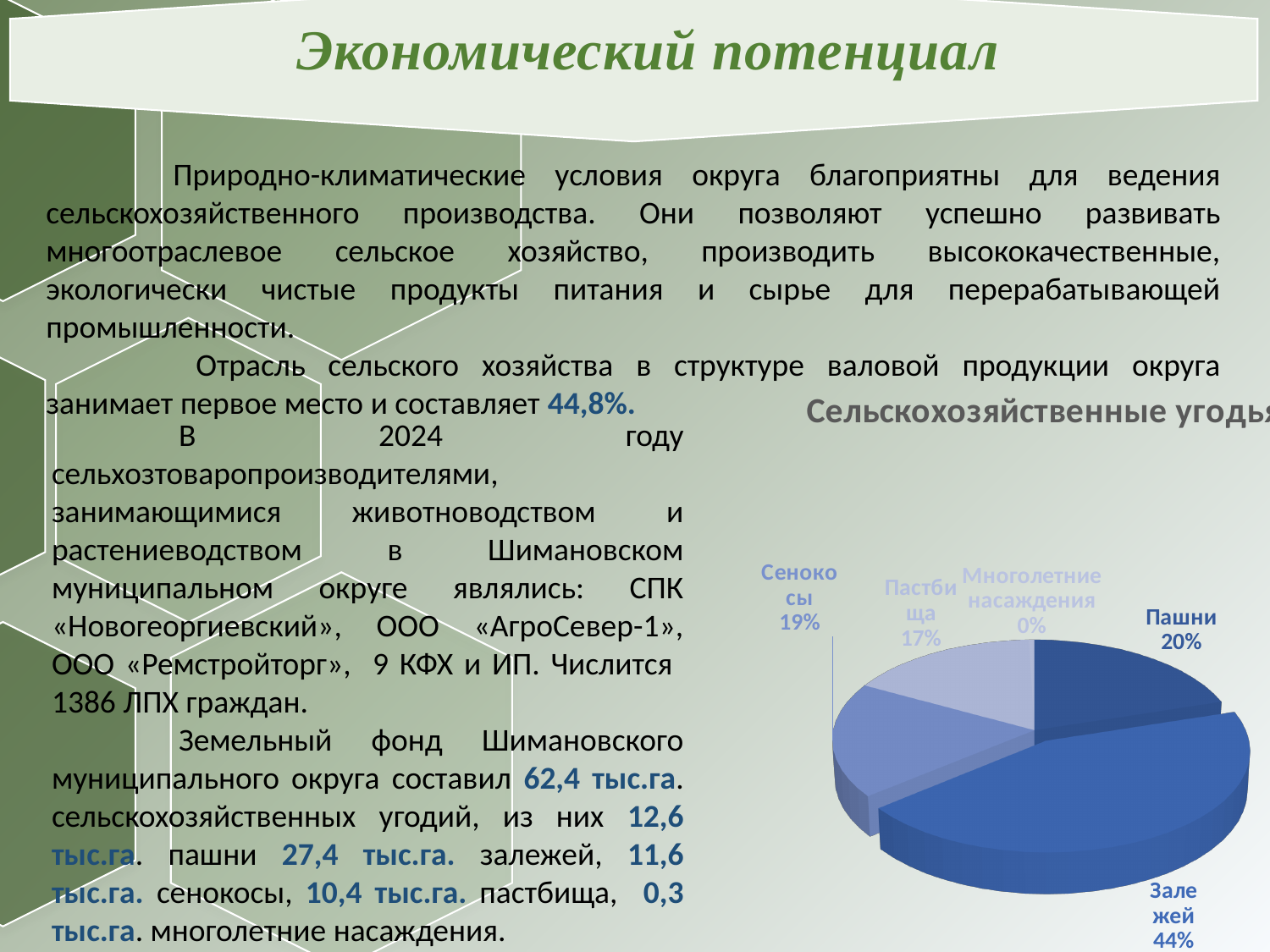
What type of chart is shown on the slide? Pie chart What percentage does the Многолетние насаждения slice represent in the pie chart? 0% Which category has the largest share in the pie chart? Залежей What percentage does the Залежей slice represent in the pie chart? 44% Which category has the smallest share in the pie chart? Многолетние насаждения By how many percentage points does the Залежей share exceed the Пашни share? 24% By how many percentage points does the Сенокосы share exceed the Пастбища share? 2% What percentage does the Сенокосы slice represent in the pie chart? 19% What percentage does the Пашни slice represent in the pie chart? 20% What percentage does the Пастбища slice represent in the pie chart? 17% How many categories are shown in the pie chart? 5 Which slice is larger, Сенокосы or Пастбища? Сенокосы